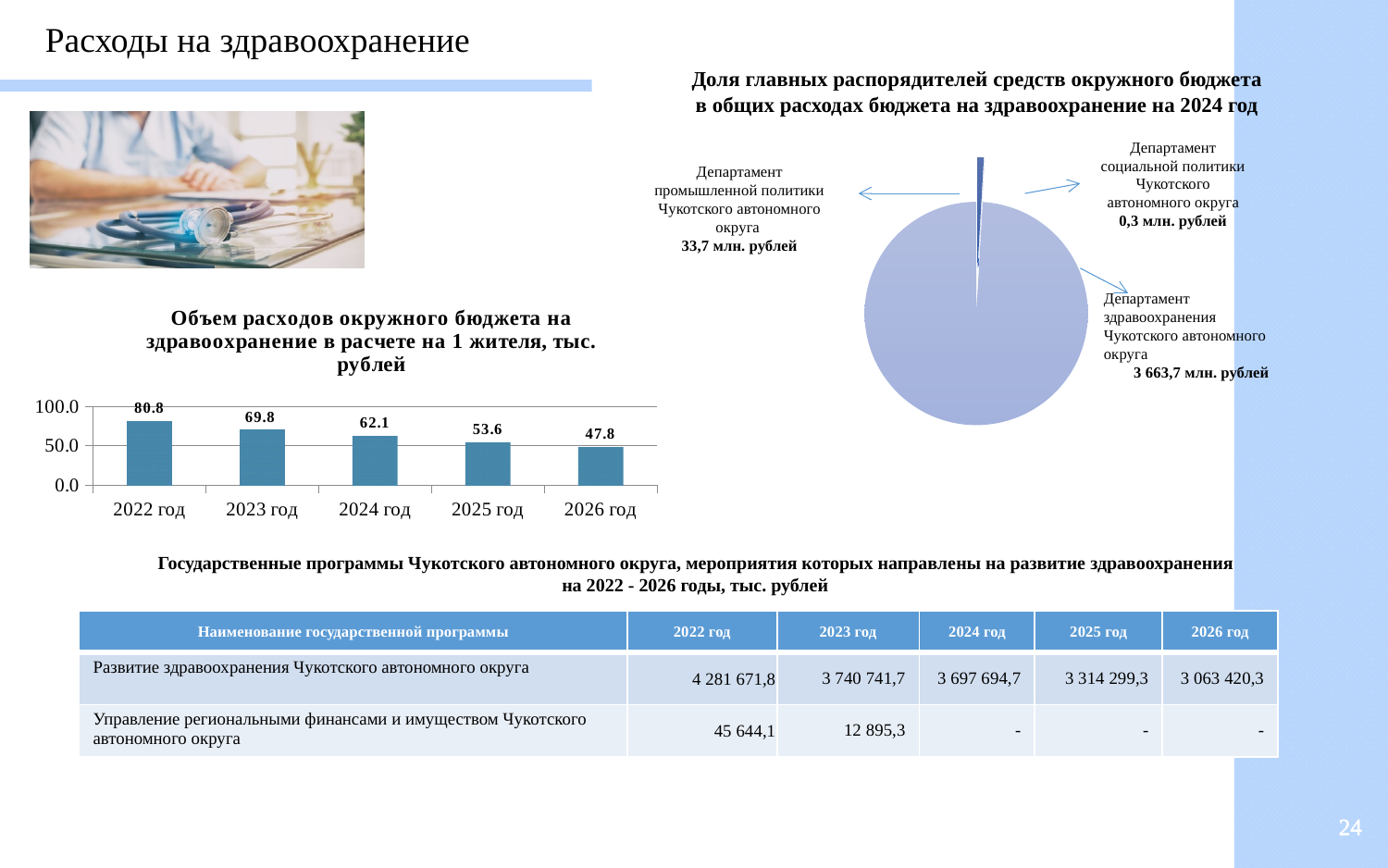
On the bar chart 'Объем расходов окружного бюджета на здравоохранение в расчете на 1 жителя, тыс. рублей', which year has the highest value? 2022 год On the bar chart 'Объем расходов окружного бюджета на здравоохранение в расчете на 1 жителя, тыс. рублей', what is the value for 2024 год? 62.1 On the bar chart 'Объем расходов окружного бюджета на здравоохранение в расчете на 1 жителя, тыс. рублей', what is the difference between the values for 2022 год and 2026 год? 33.0 On the bar chart 'Объем расходов окружного бюджета на здравоохранение в расчете на 1 жителя, тыс. рублей', what is the value for 2026 год? 47.8 On the bar chart 'Объем расходов окружного бюджета на здравоохранение в расчете на 1 жителя, тыс. рублей', which is larger, the value for 2023 год or 2025 год? 2023 год What kind of chart is the chart titled 'Доля главных распорядителей средств окружного бюджета в общих расходах бюджета на здравоохранение на 2024 год'? pie chart On the bar chart 'Объем расходов окружного бюджета на здравоохранение в расчете на 1 жителя, тыс. рублей', do the values rise or fall from 2022 год to 2026 год? fall On the bar chart 'Объем расходов окружного бюджета на здравоохранение в расчете на 1 жителя, тыс. рублей', which year has the lowest value? 2026 год On the pie chart 'Доля главных распорядителей средств окружного бюджета в общих расходах бюджета на здравоохранение на 2024 год', what is the value for Департамент промышленной политики Чукотского автономного округа? 33,7 млн. рублей On the bar chart 'Объем расходов окружного бюджета на здравоохранение в расчете на 1 жителя, тыс. рублей', what is the value for 2022 год? 80.8 On the pie chart 'Доля главных распорядителей средств окружного бюджета в общих расходах бюджета на здравоохранение на 2024 год', which department has the largest slice? Департамент здравоохранения Чукотского автономного округа On the bar chart 'Объем расходов окружного бюджета на здравоохранение в расчете на 1 жителя, тыс. рублей', how many years are shown? 5